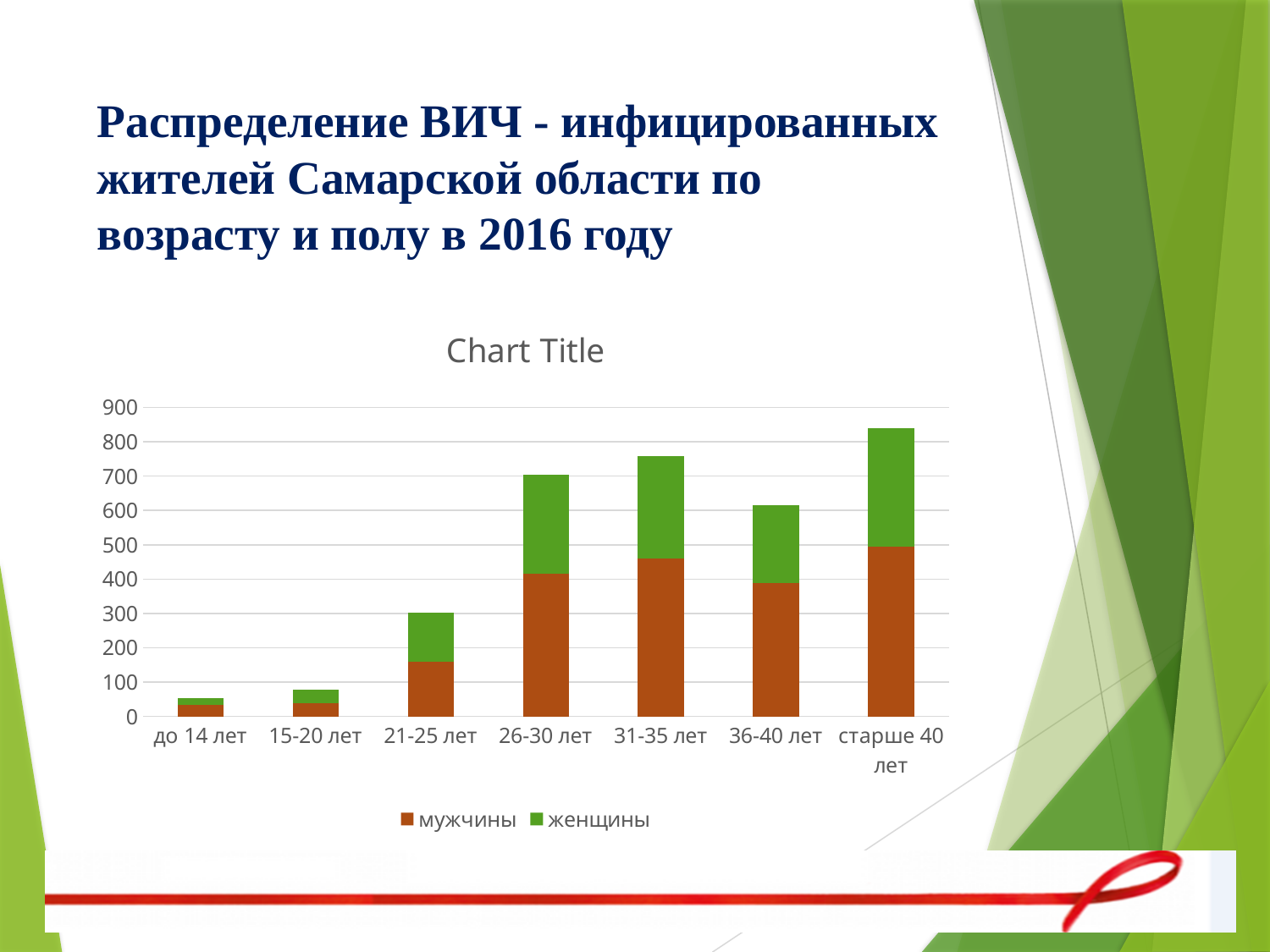
Is the value for мужчины in the 31-35 лет category greater or less than 400? greater Which colour represents the series женщины in the legend? green Which age category has the largest value for мужчины? старше 40 лет Which age category has the highest total bar? старше 40 лет Which has the larger total bar, 26-30 лет or 36-40 лет? 26-30 лет Is the value for мужчины in the 21-25 лет category greater or less than 200? less What kind of chart is shown on the slide? stacked bar chart How many series does the legend list? 2 Is the total bar for старше 40 лет greater or less than 800? greater Which age category has the lowest total bar? до 14 лет How many age categories are shown on the x axis? 7